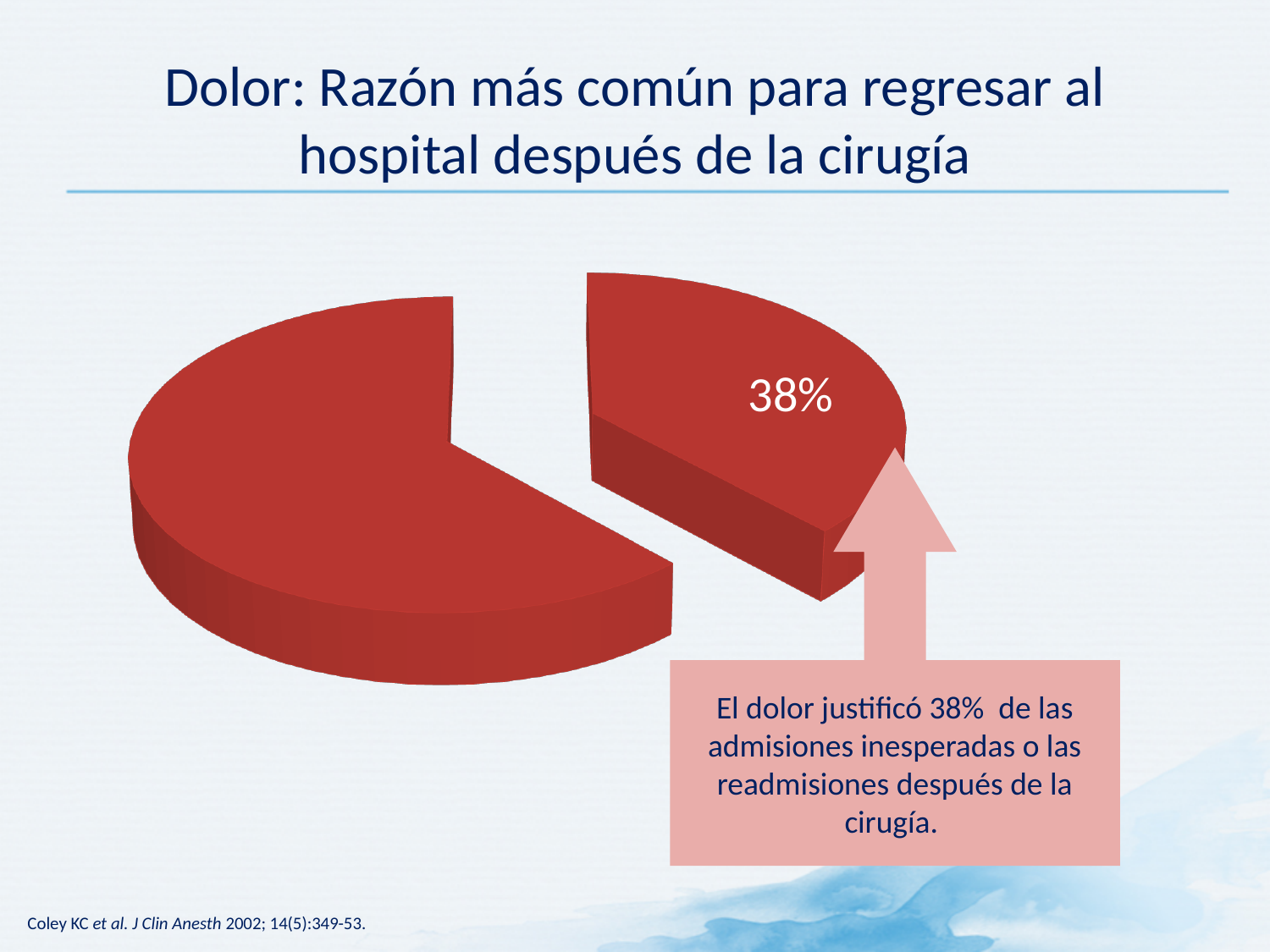
How many slices does the pie chart have? 2 What kind of chart is shown on the slide? Pie chart According to the slide, what share of unexpected admissions or readmissions after surgery was due to pain? 38% Is the exploded slice labeled 38% larger or smaller than the other slice of the pie? smaller What percentage is printed on the exploded (separated) slice of the pie chart? 38% What colour are the slices of the pie chart? Red What is the title of the slide containing the pie chart? Dolor: Razón más común para regresar al hospital después de la cirugía Which slice of the pie chart is the largest: the one labeled 38% or the unlabeled one? the unlabeled one Is the share of the slice labeled 38% greater or less than 50%? less